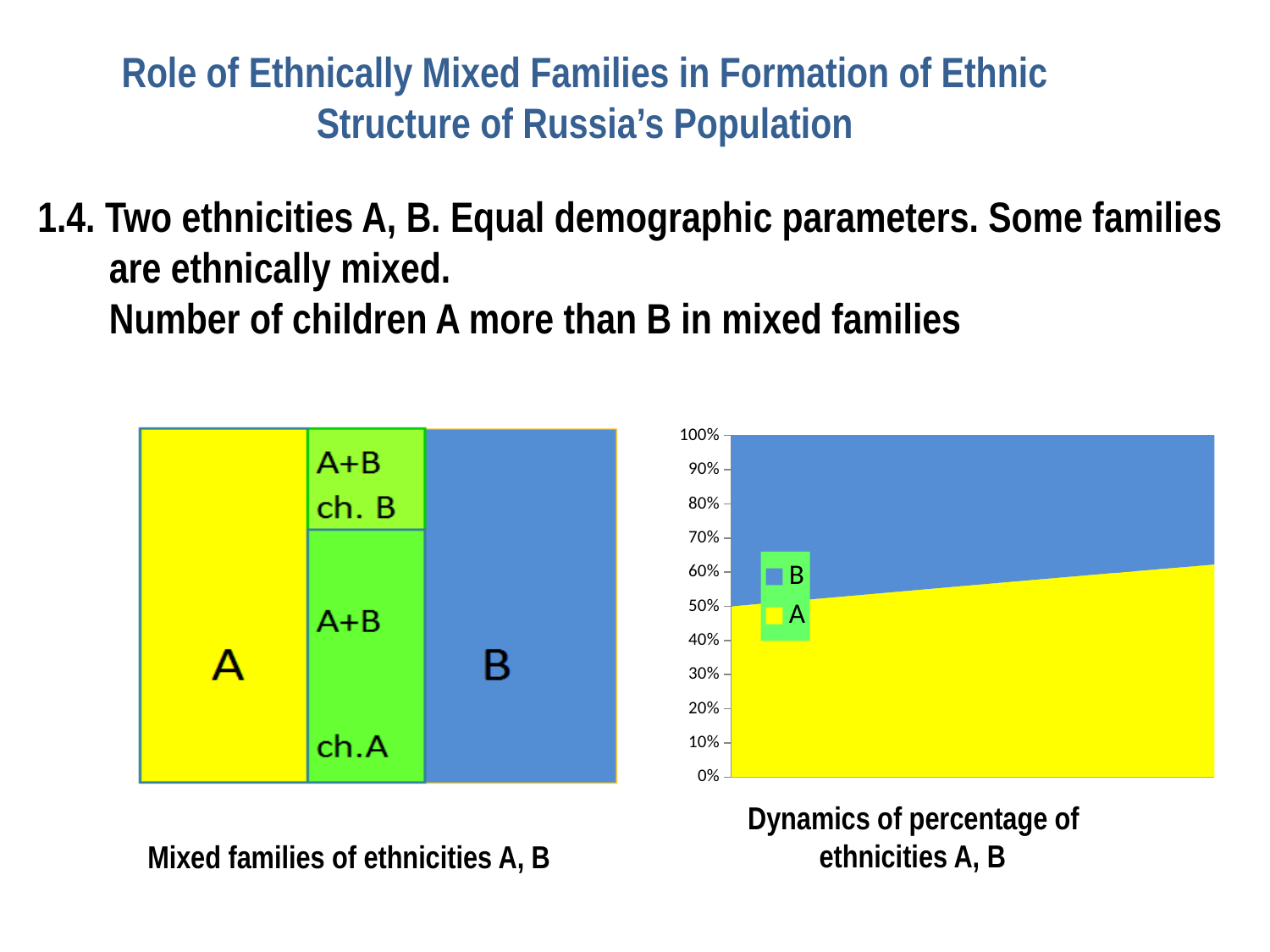
In the chart titled "Dynamics of percentage of ethnicities A, B", what is the highest value shown on the y axis? 100% In the chart titled "Dynamics of percentage of ethnicities A, B", does the share of A rise or fall along the x axis? Rise In the chart titled "Dynamics of percentage of ethnicities A, B", what kind of chart is it? Stacked area chart In the chart titled "Dynamics of percentage of ethnicities A, B", at the right end of the chart, is the share of A greater or less than 50%? greater In the chart titled "Dynamics of percentage of ethnicities A, B", how many series does the legend list? 2 In the chart titled "Dynamics of percentage of ethnicities A, B", which colour represents series A? Yellow In the chart titled "Dynamics of percentage of ethnicities A, B", at the right end of the chart, is the share of B greater or less than 50%? less In the chart titled "Dynamics of percentage of ethnicities A, B", what are the two legend entries? B and A In the chart titled "Dynamics of percentage of ethnicities A, B", does the share of B rise or fall along the x axis? Fall In the chart titled "Dynamics of percentage of ethnicities A, B", at the right end of the chart, which series has the larger share, A or B? A